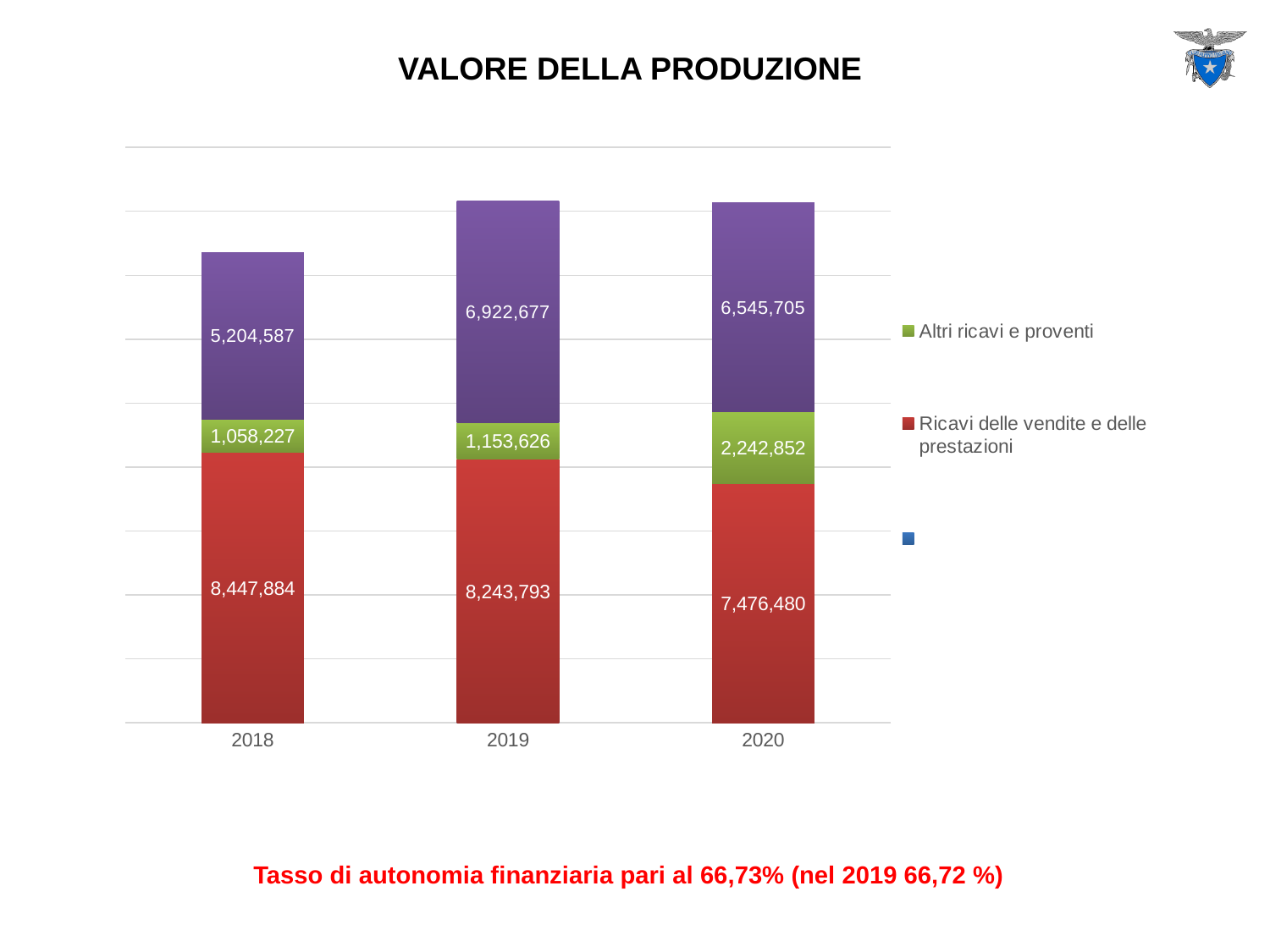
How many years are shown on the x axis? 3 In which year is Altri ricavi e proventi highest? 2020 In which year is Ricavi delle vendite e delle prestazioni lowest? 2020 What kind of chart is shown on the slide? Stacked bar chart What is the value of Ricavi delle vendite e delle prestazioni in 2018? 8,447,884 What is the title of the chart? VALORE DELLA PRODUZIONE What is the total of the stacked bar for 2018? 14,710,698 What is the value of the purple (top) segment of the 2019 bar? 6,922,677 What is the value of Altri ricavi e proventi in 2020? 2,242,852 By how much did Ricavi delle vendite e delle prestazioni decrease from 2018 to 2020? 971,404 Does Ricavi delle vendite e delle prestazioni rise or fall from 2018 to 2020? Fall Is the purple (top) segment larger in 2019 or in 2020? 2019